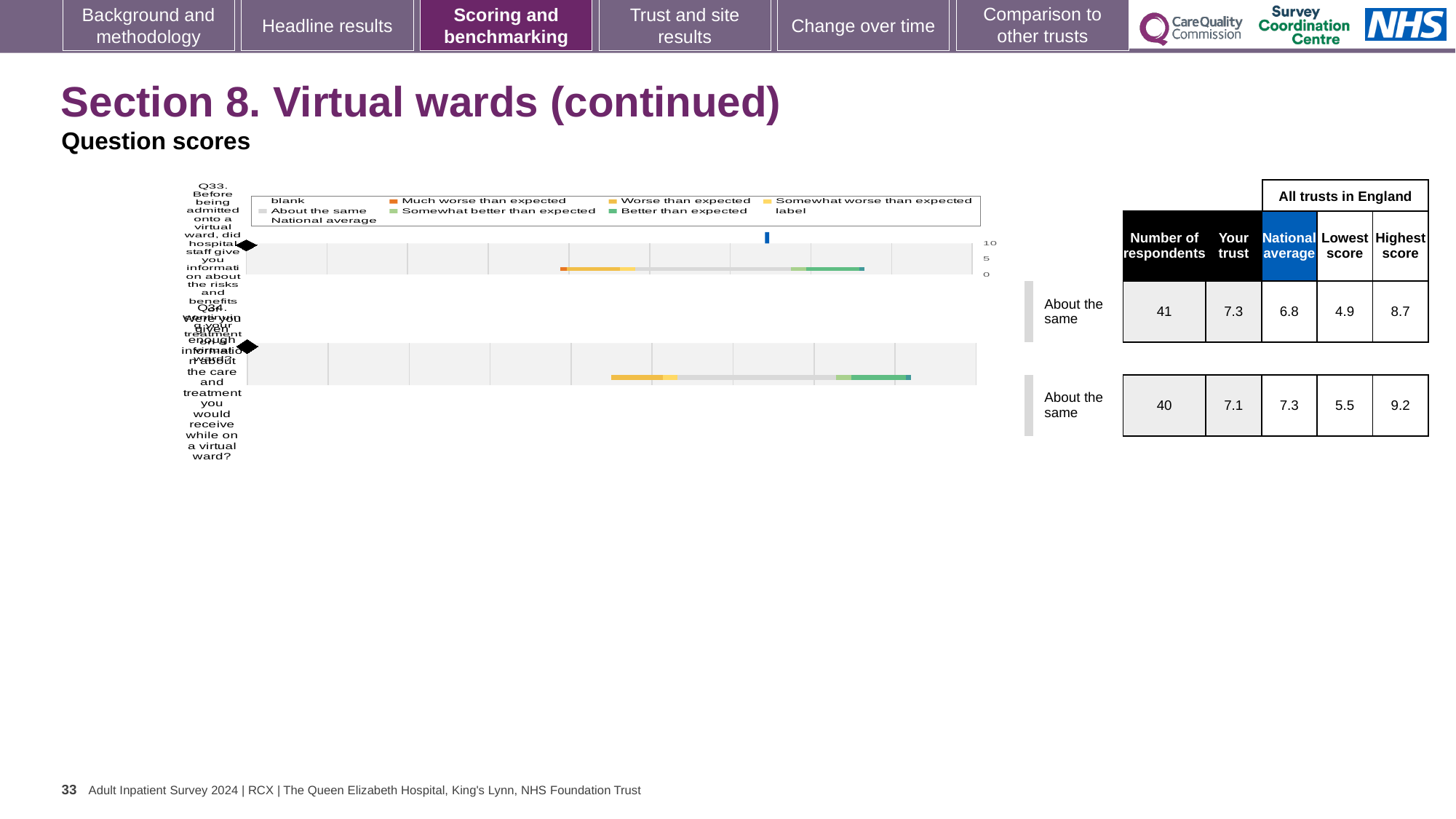
How many respondents answered Q33? 41 Which question has the lower 'Lowest score' across all trusts in England, Q33 or Q34? Q33 How many questions are plotted in the chart on this slide? 2 What is the highest score across all trusts in England for Q34? 9.2 What benchmark category is shown next to the chart for both Q33 and Q34? About the same What is the national average score for Q34 (enough information about care and treatment on a virtual ward)? 7.3 What is the 'Your trust' score for Q33 (information about the risks and benefits of a virtual ward)? 7.3 For Q34, which is larger: the 'Your trust' score or the national average? National average For Q33, which is larger: the 'Your trust' score or the national average? Your trust What kind of chart is used to show the question scores for Q33 and Q34? bar chart What is the difference between the highest and lowest scores across all trusts in England for Q34? 3.7 What is the difference between the 'Your trust' score and the national average for Q33? 0.5